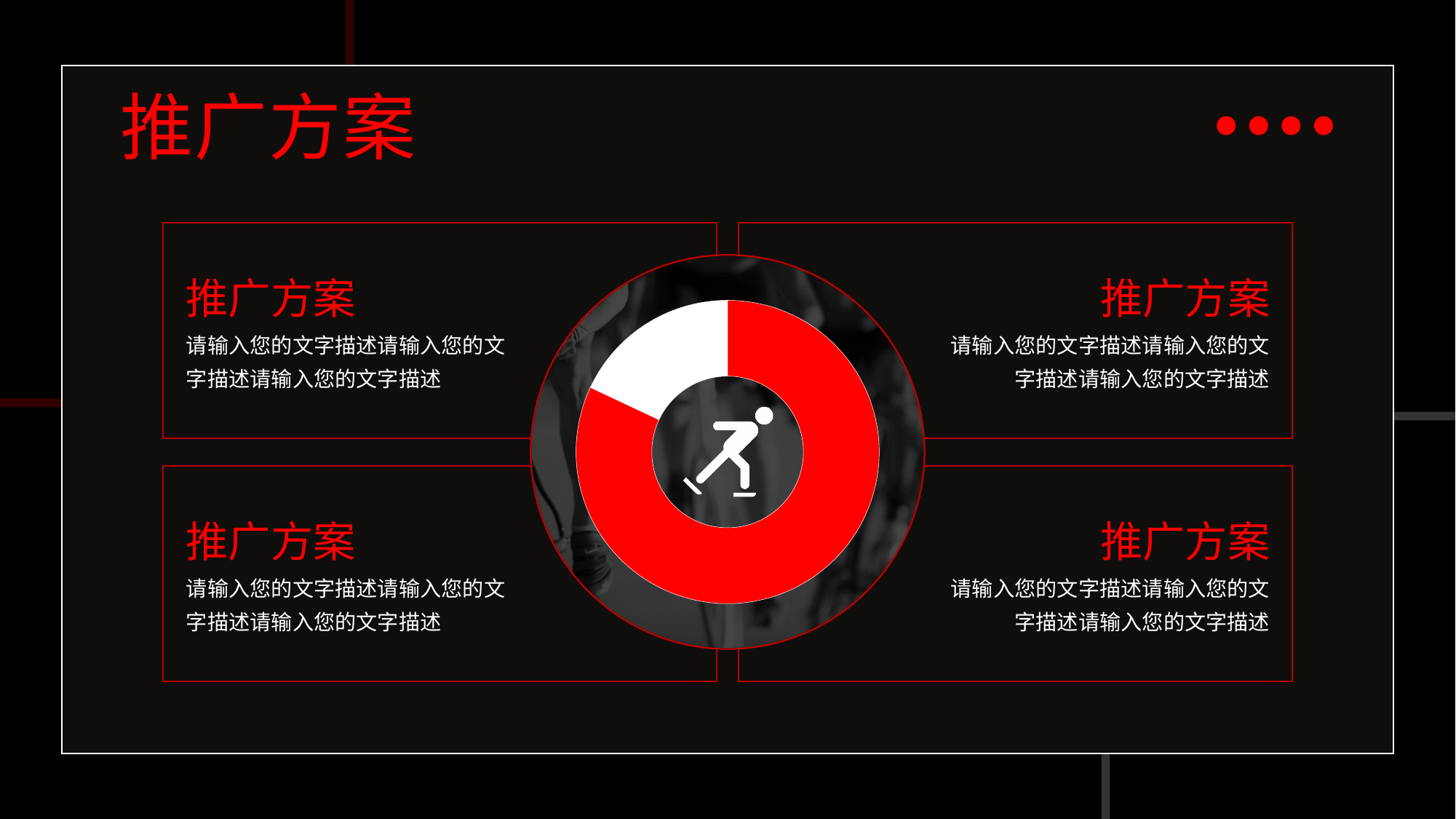
Which slice of the doughnut chart is the smallest? the white slice Does the white slice of the doughnut chart take up more or less than half of the ring? less What icon is shown in the hole at the centre of the doughnut chart? a speed skater What two colours are used for the slices of the doughnut chart? red and white How many slices does the doughnut chart in the centre of the slide have? 2 What kind of chart is shown in the centre of the slide? doughnut chart Which slice of the doughnut chart is the largest? the red slice In the doughnut chart, which slice is larger, the red one or the white one? the red one